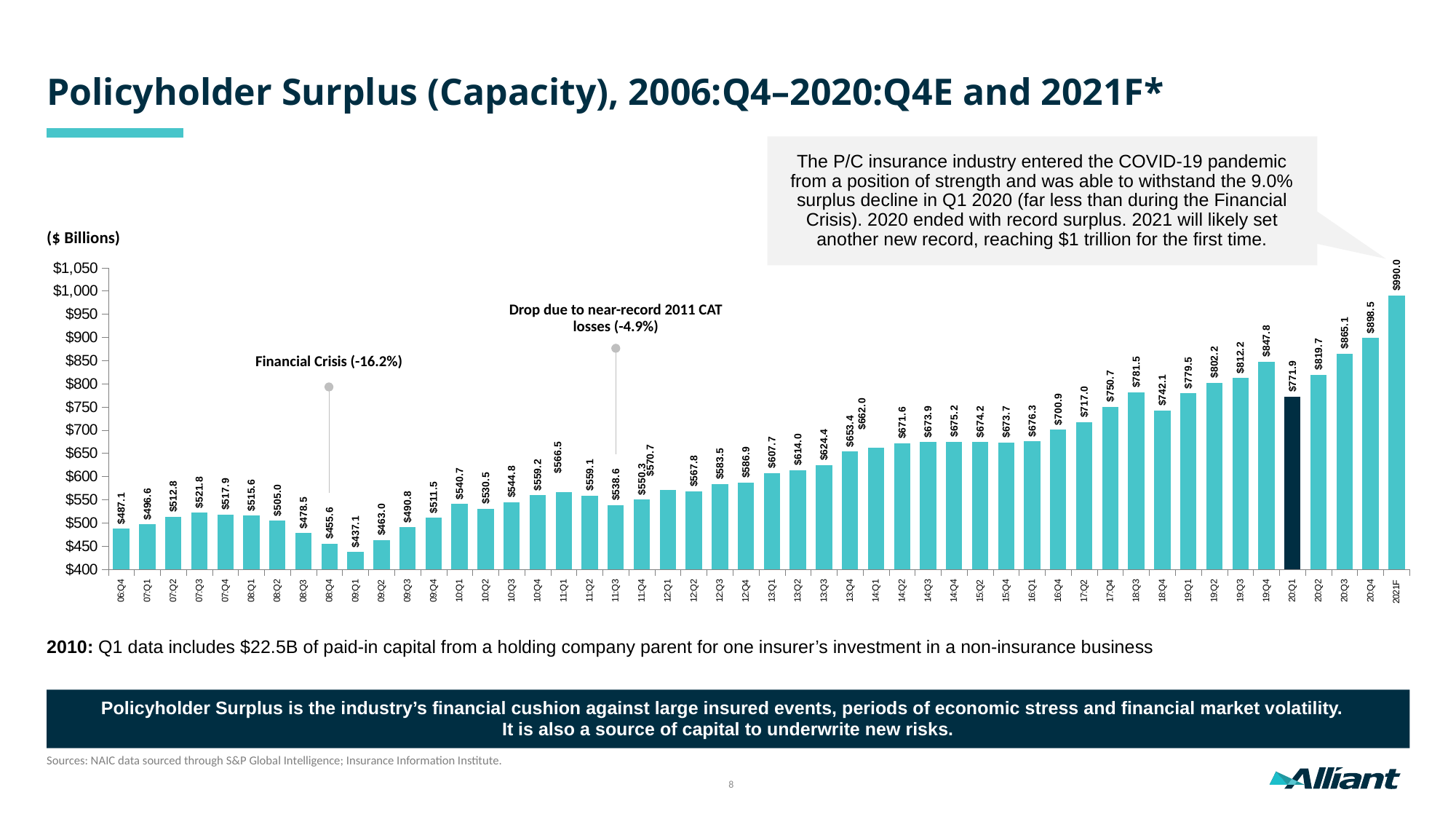
Which period has the highest policyholder surplus on the chart? 2021F Is the policyholder surplus for 16:Q4 greater or less than $650? greater What is the policyholder surplus value shown for 2021F? $990.0 Which is larger, the policyholder surplus for 19:Q4 or for 20:Q2? 19:Q4 Which period has the lowest policyholder surplus on the chart? 09:Q1 Which bar on the chart is coloured dark navy instead of teal? 20:Q1 What kind of chart is shown on the slide? Bar chart Overall, does the policyholder surplus rise or fall from 06:Q4 to 2021F? Rise What is the policyholder surplus value shown for 09:Q1? $437.1 What is the difference between the policyholder surplus for 20:Q4 and 20:Q1? $126.6 What percentage decline does the chart annotation attribute to the Financial Crisis? -16.2% What is the policyholder surplus value shown for 20:Q1? $771.9